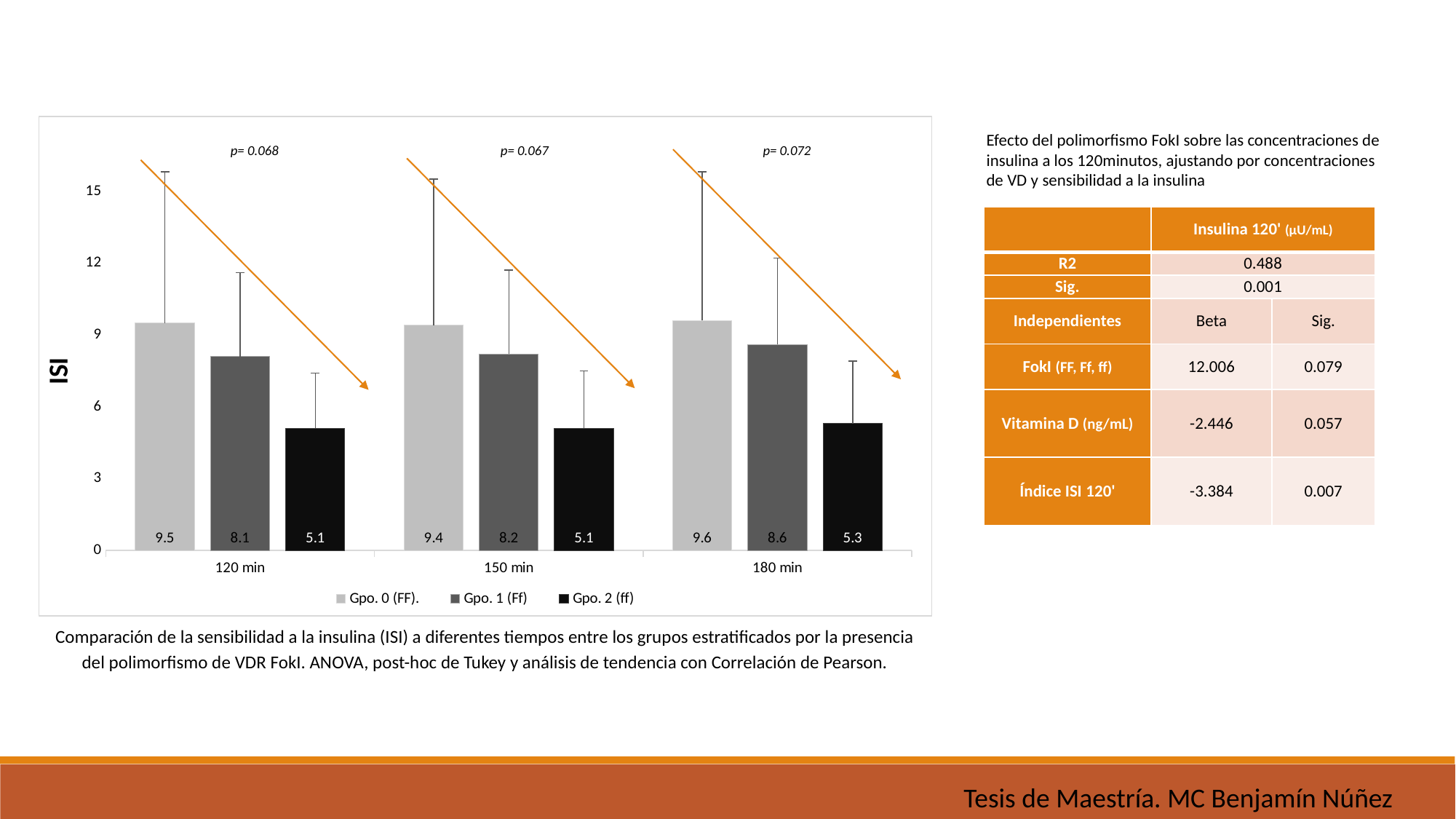
Which is larger: the ISI value for Gpo. 1 (Ff) at 180 min or at 120 min? 180 min What is the label of the y axis of the chart? ISI What is the difference between the ISI values of Gpo. 0 (FF) and Gpo. 2 (ff) at 150 min? 4.3 How many time points are shown on the x axis of the chart? 3 What is the ISI value for Gpo. 2 (ff) at 180 min? 5.3 Is the ISI value for Gpo. 2 (ff) at 150 min greater or less than 6? less What kind of chart is shown on the slide? bar chart How many series does the chart legend list? 3 Which group has the highest ISI value at 180 min? Gpo. 0 (FF) Which group has the lowest ISI value at 120 min? Gpo. 2 (ff) What is the ISI value for Gpo. 1 (Ff) at 150 min? 8.2 What is the ISI value for Gpo. 0 (FF) at 120 min? 9.5